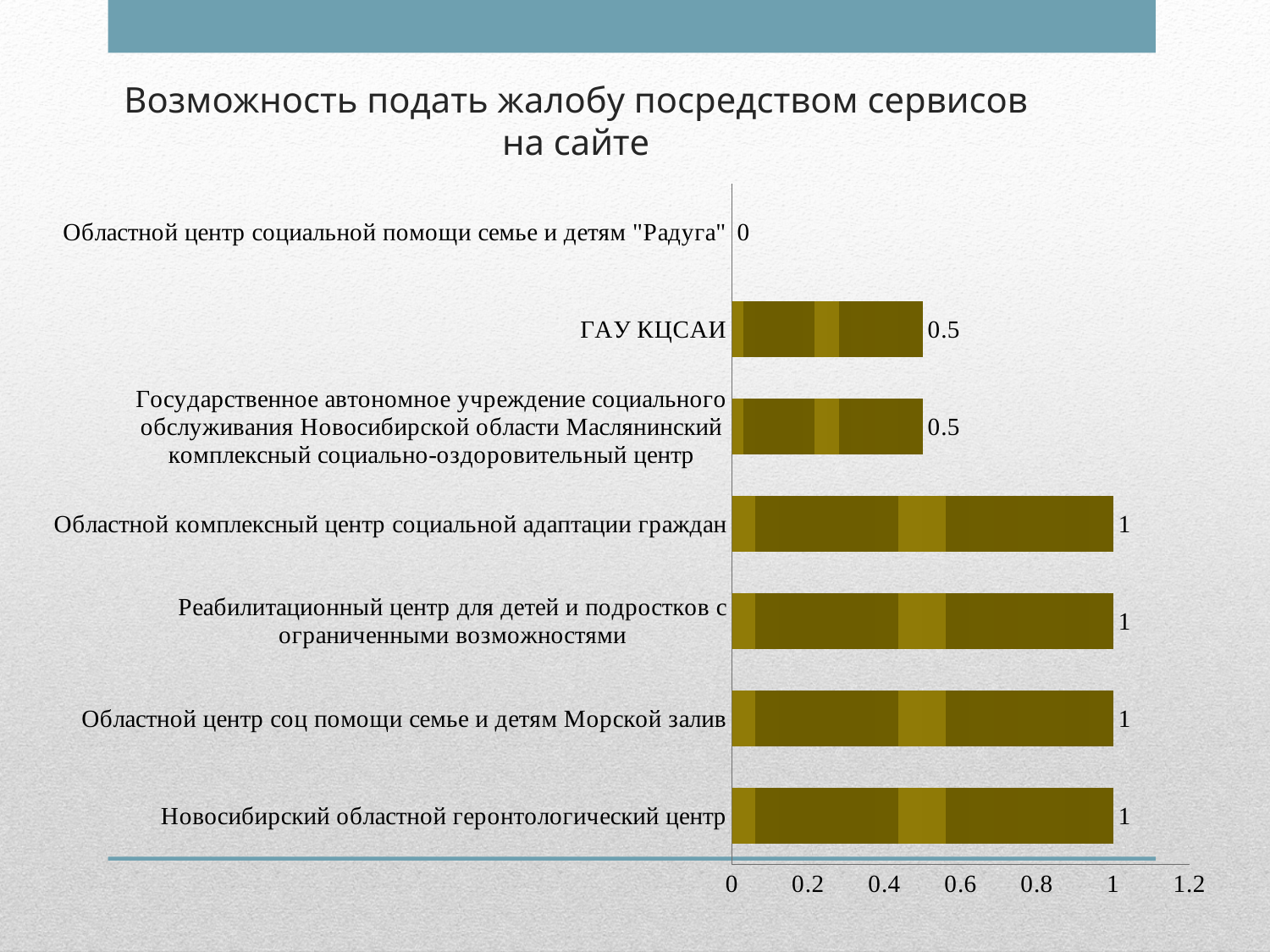
What is the value for ГАУ КЦСАИ? 0.5 What is the value for Областной центр социальной помощи семье и детям "Радуга"? 0 How many categories have a value of 1? 4 What is the title of the chart? Возможность подать жалобу посредством сервисов на сайте What is the value for Областной комплексный центр социальной адаптации граждан? 1 What is the difference between the value for Областной центр соц помощи семье и детям Морской залив and the value for ГАУ КЦСАИ? 0.5 What is the highest tick value shown on the horizontal axis? 1.2 What kind of chart is shown on the slide? Bar chart What is the value for Новосибирский областной геронтологический центр? 1 Which category has the lowest value? Областной центр социальной помощи семье и детям "Радуга" Which is larger: the value for Реабилитационный центр для детей и подростков с ограниченными возможностями or the value for ГАУ КЦСАИ? Реабилитационный центр для детей и подростков с ограниченными возможностями How many categories are shown in the chart? 7